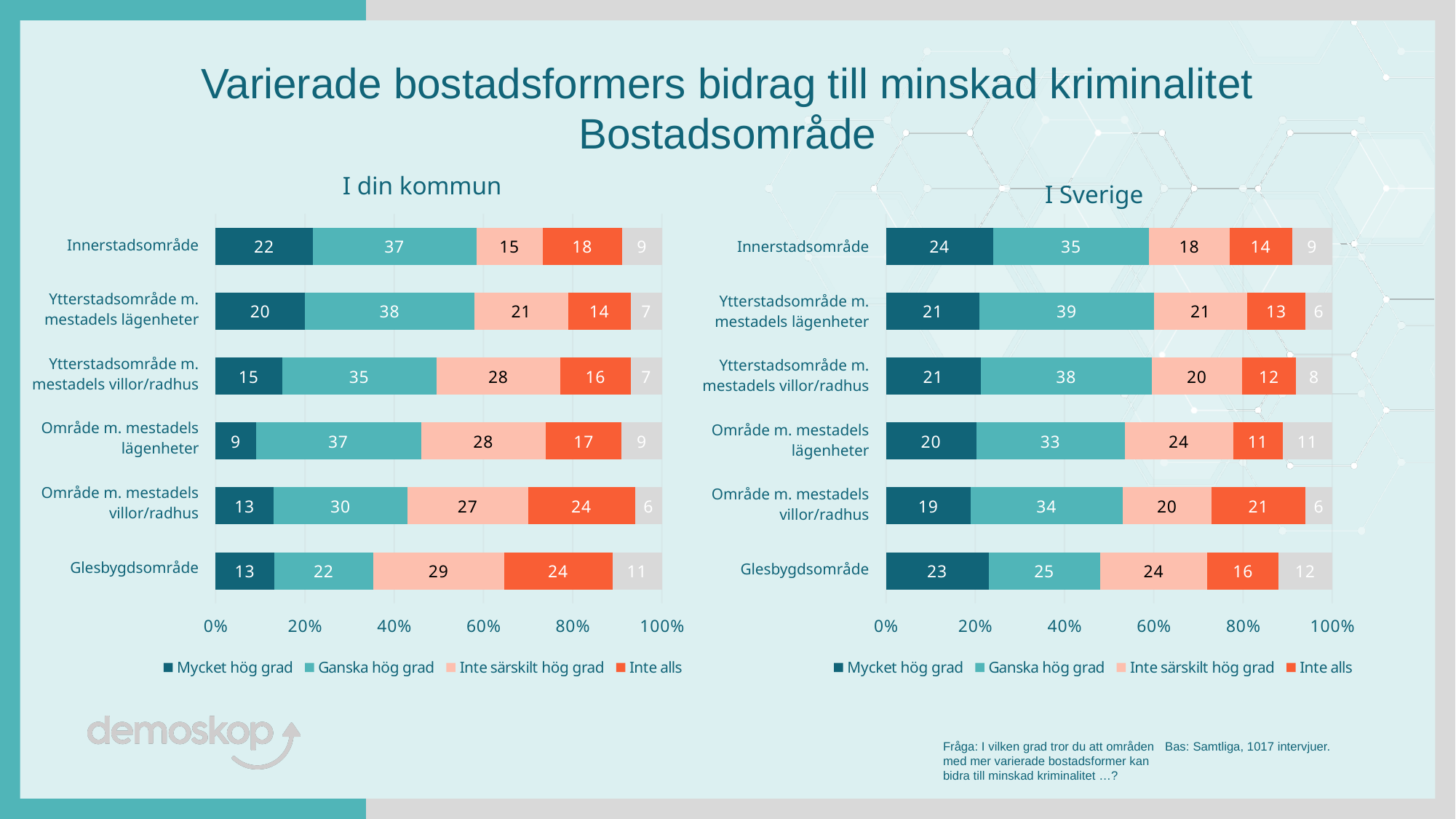
In the 'I Sverige' chart, which has the larger 'Ganska hög grad' value: Ytterstadsområde m. mestadels lägenheter or Glesbygdsområde? Ytterstadsområde m. mestadels lägenheter In the 'I din kommun' chart, what is the difference between the 'Inte alls' values for Glesbygdsområde and Innerstadsområde? 6 What is the title of the chart on the left side of the slide? I din kommun In the 'I din kommun' chart, which category has the highest value for 'Mycket hög grad'? Innerstadsområde In the 'I din kommun' chart, what is the value for 'Mycket hög grad' for Innerstadsområde? 22 How many categories are shown in the 'I Sverige' chart? 6 In the 'I din kommun' chart, which category has the lowest value for 'Mycket hög grad'? Område m. mestadels lägenheter In the 'I din kommun' chart, what is the value for 'Inte alls' for Område m. mestadels villor/radhus? 24 In the 'I Sverige' chart, what is the value for 'Ganska hög grad' for Glesbygdsområde? 25 What kind of chart is the 'I Sverige' chart? Stacked bar chart In the 'I Sverige' chart, which category has the highest value for 'Inte alls'? Område m. mestadels villor/radhus How many series does the legend of the 'I din kommun' chart list? 4